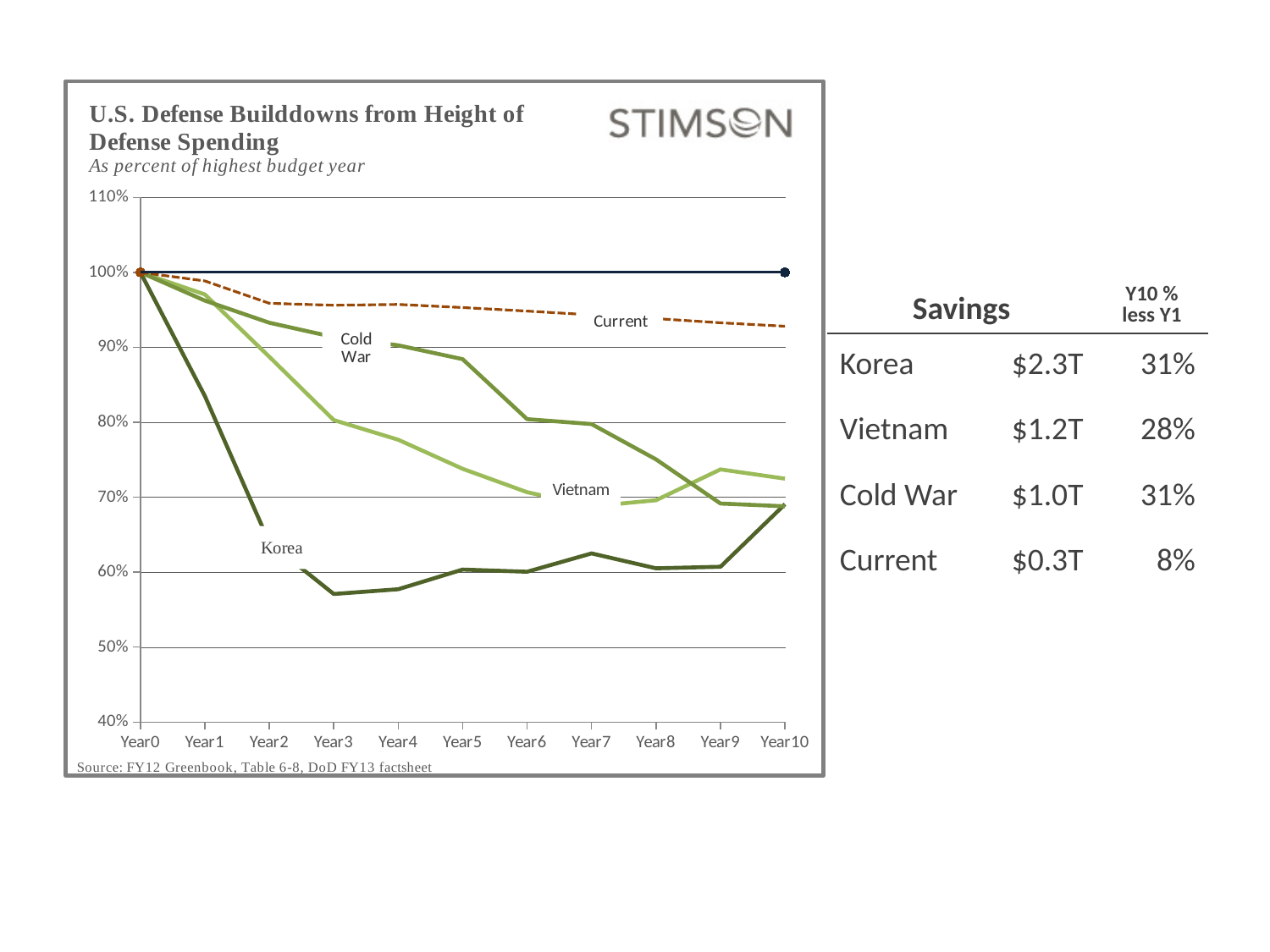
How many year points are shown on the x axis of the chart? 11 Is the value for Current at Year10 greater or less than 90%? greater Does the Korea line rise or fall from Year0 to Year3? fall Is the value for Cold War at Year5 greater or less than 90%? less Is the value for Korea at Year3 greater or less than 60%? less What is the title of the chart? U.S. Defense Builddowns from Height of Defense Spending What is the value of the Korea line at Year0? 100% At Year5, which is higher: Cold War or Vietnam? Cold War How many named series (Korea, Vietnam, Cold War, Current) are labeled on the chart? 4 Which series has the lowest value at Year3? Korea What kind of chart is shown on the slide? line chart